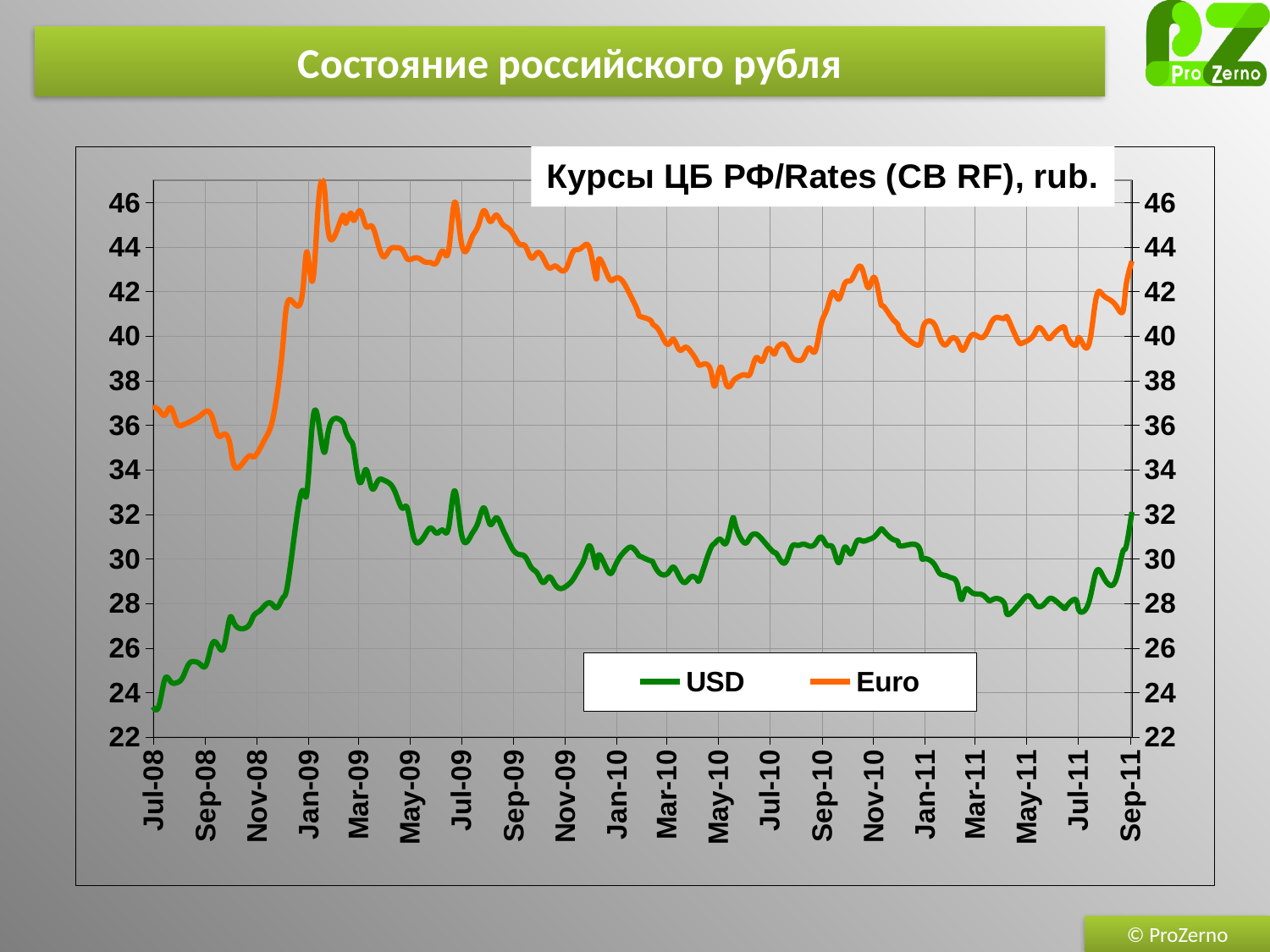
Is the value for Euro at Jul-08 greater or less than 36? greater Is the value for USD at Nov-08 greater or less than 28? less Does the USD series rise or fall from Jul-08 to Jan-09? rise Which series is higher at Jan-10, USD or Euro? Euro Is the value for Euro at Nov-08 greater or less than 36? less How many series does the legend list? 2 Does the Euro series rise or fall from Jul-09 to May-10? fall What is the title of the chart? Курсы ЦБ РФ/Rates (CB RF), rub. Which colour is used for the Euro series? orange What kind of chart is shown on the slide? line chart